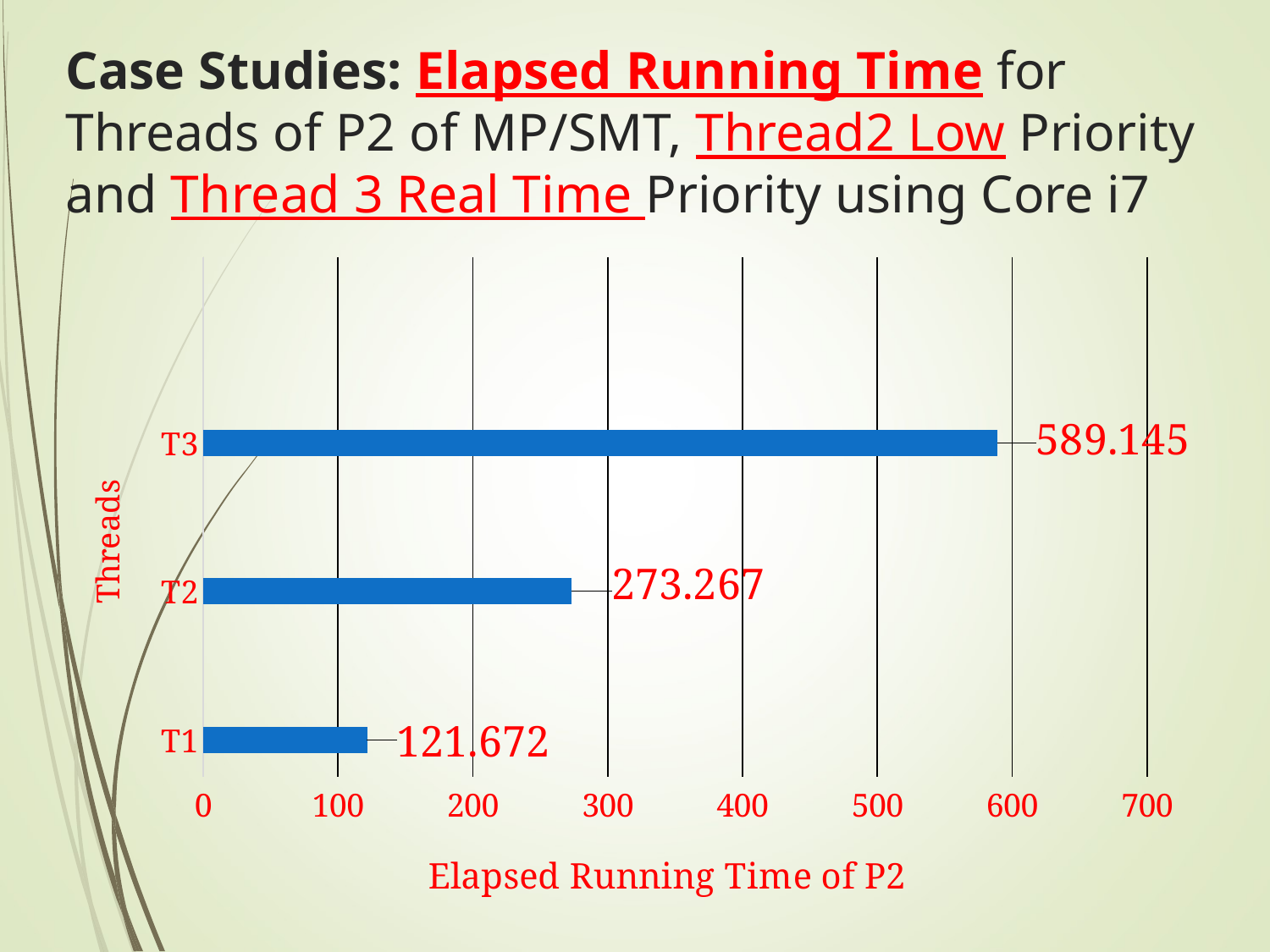
What is the elapsed running time for T3? 589.145 What is the difference in elapsed running time between T3 and T2? 315.878 Which thread has the highest elapsed running time? T3 What is the difference in elapsed running time between T2 and T1? 151.595 Which has a larger elapsed running time, T2 or T1? T2 What kind of chart is shown on the slide? Bar chart What is the label of the horizontal axis of the chart? Elapsed Running Time of P2 What is the elapsed running time for T1? 121.672 Is the value for T3 greater or less than 500? greater What is the elapsed running time for T2? 273.267 Which thread has the lowest elapsed running time? T1 How many threads are plotted in the chart? 3